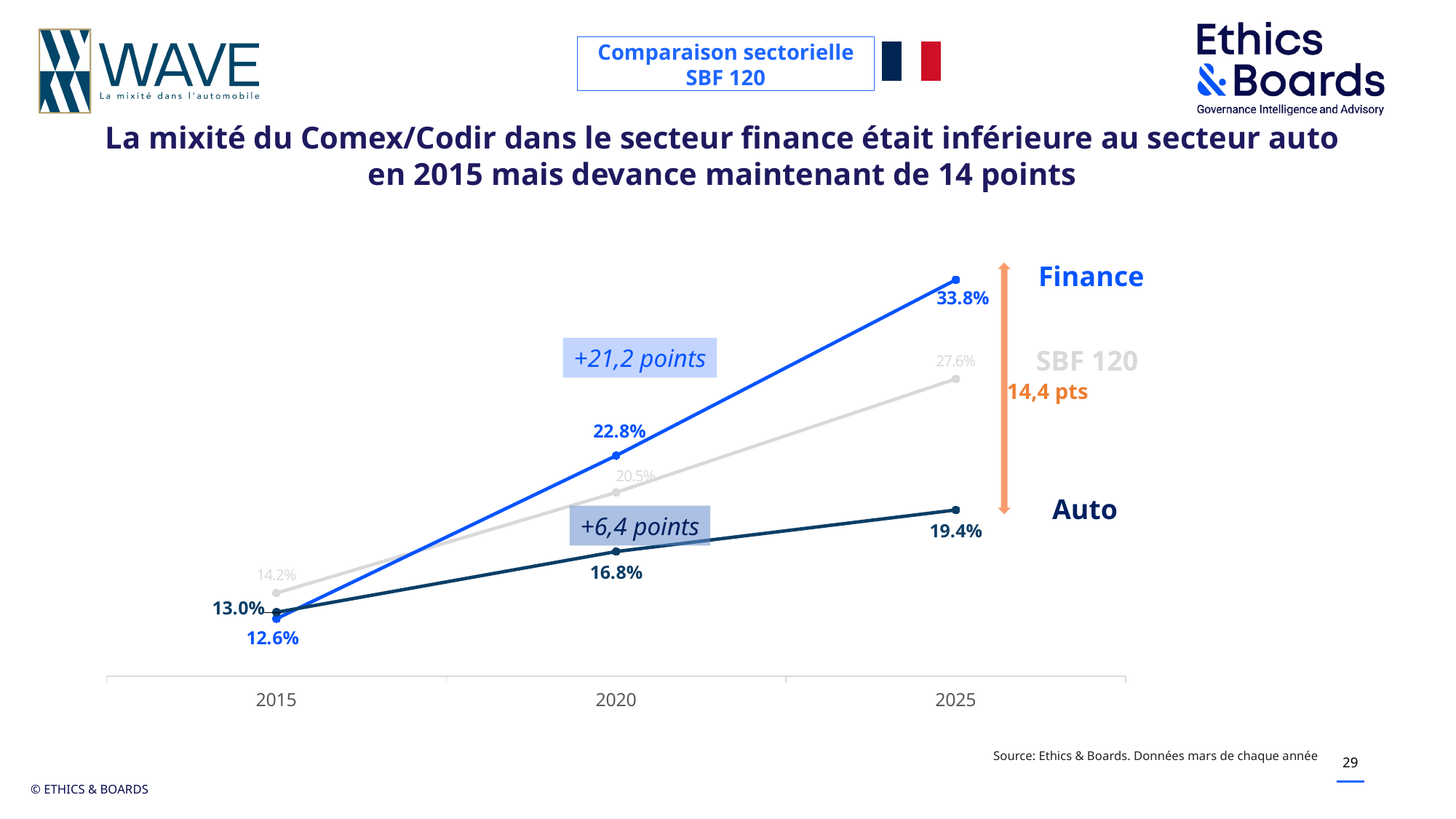
How many years are shown on the x axis? 3 What is the value for Finance in 2025? 33.8% Which is larger in 2020, the SBF 120 value or the Auto value? SBF 120 What is the value for Finance in 2015? 12.6% Which series has the highest value in 2025? Finance What is the value for SBF 120 in 2015? 14.2% Which series has the lowest value in 2015? Finance What is the difference between the SBF 120 values in 2025 and 2015? 13.4 points What is the value for Auto in 2020? 16.8% What kind of chart is shown on the slide? Line chart Does the Auto series rise or fall from 2015 to 2025? Rise What is the difference between the Finance and Auto values in 2025? 14.4 points